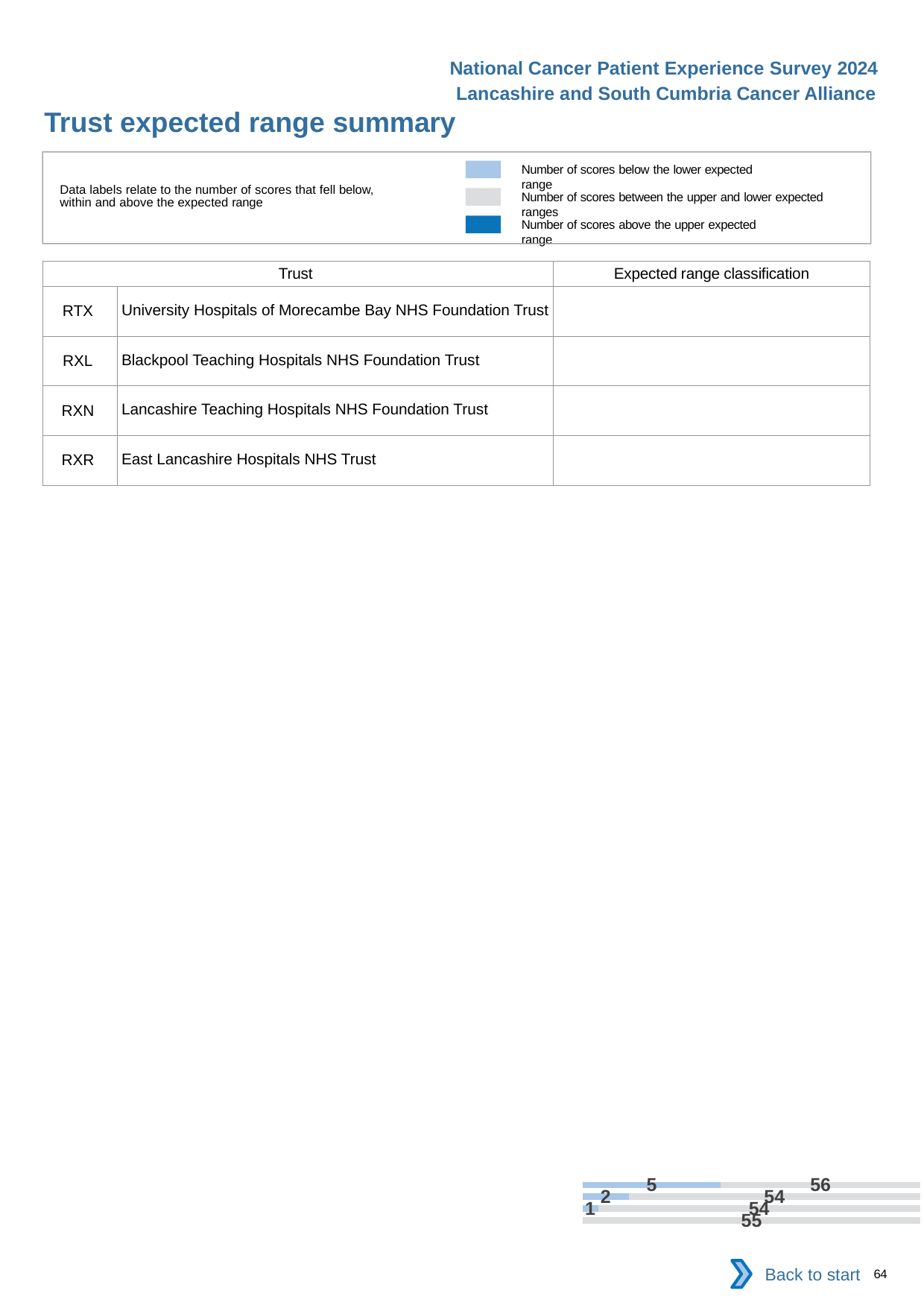
In the chart at the bottom of the slide, what is the value of the light blue segment of the top bar? 5 In the chart at the bottom of the slide, what is the total of the top bar? 61 How many categories does the legend box at the top of the slide list? 3 In the chart at the bottom of the slide, what is the value of the grey segment of the bottom bar? 55 In the chart at the bottom of the slide, what is the value of the light blue segment of the second bar from the top? 2 How many bars are plotted in the chart at the bottom of the slide? 4 In the chart at the bottom of the slide, what is the difference between the grey segment of the top bar and the grey segment of the bottom bar? 1 What kind of chart is shown at the bottom of the slide? Stacked bar chart According to the legend, what does the dark blue colour represent? Number of scores above the upper expected range In the chart at the bottom of the slide, which bar has the largest grey segment? The top bar In the chart at the bottom of the slide, what is the value of the light blue segment of the third bar from the top? 1 In the chart at the bottom of the slide, what is the value of the grey segment of the top bar? 56